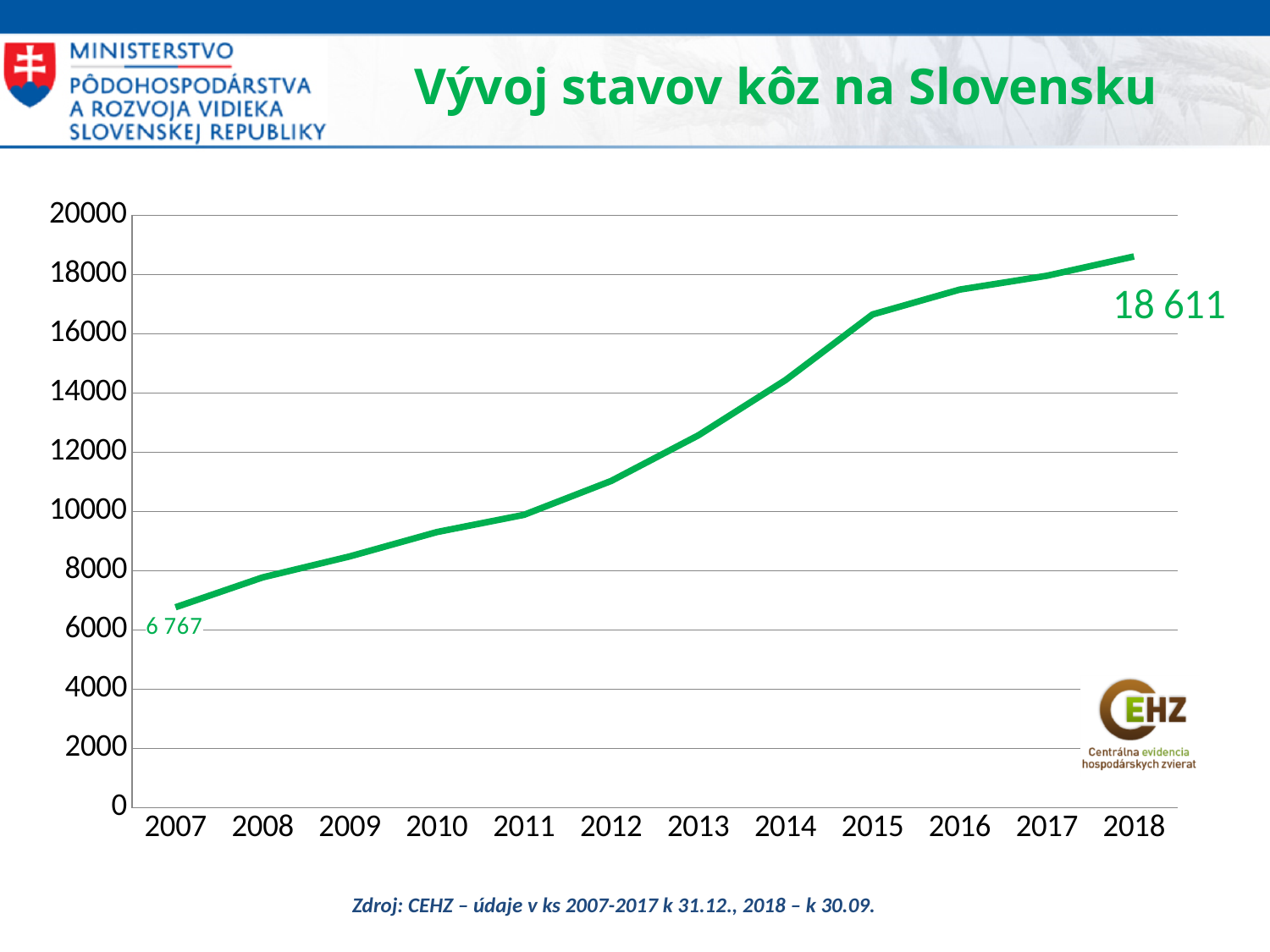
Which year has the lowest value on the chart? 2007 Which year has the larger value, 2010 or 2015? 2015 What is the value shown for 2007? 6 767 Is the value for 2012 greater or less than 10000? greater Which year has the highest value on the chart? 2018 Do the values rise or fall from 2007 to 2018? rise What is the difference between the 2018 value and the 2007 value? 11 844 What is the value shown for 2018? 18 611 Is the value for 2015 greater or less than 14000? greater What kind of chart is shown on the slide? line chart Is the value for 2010 greater or less than 10000? less How many years are shown on the x axis? 12